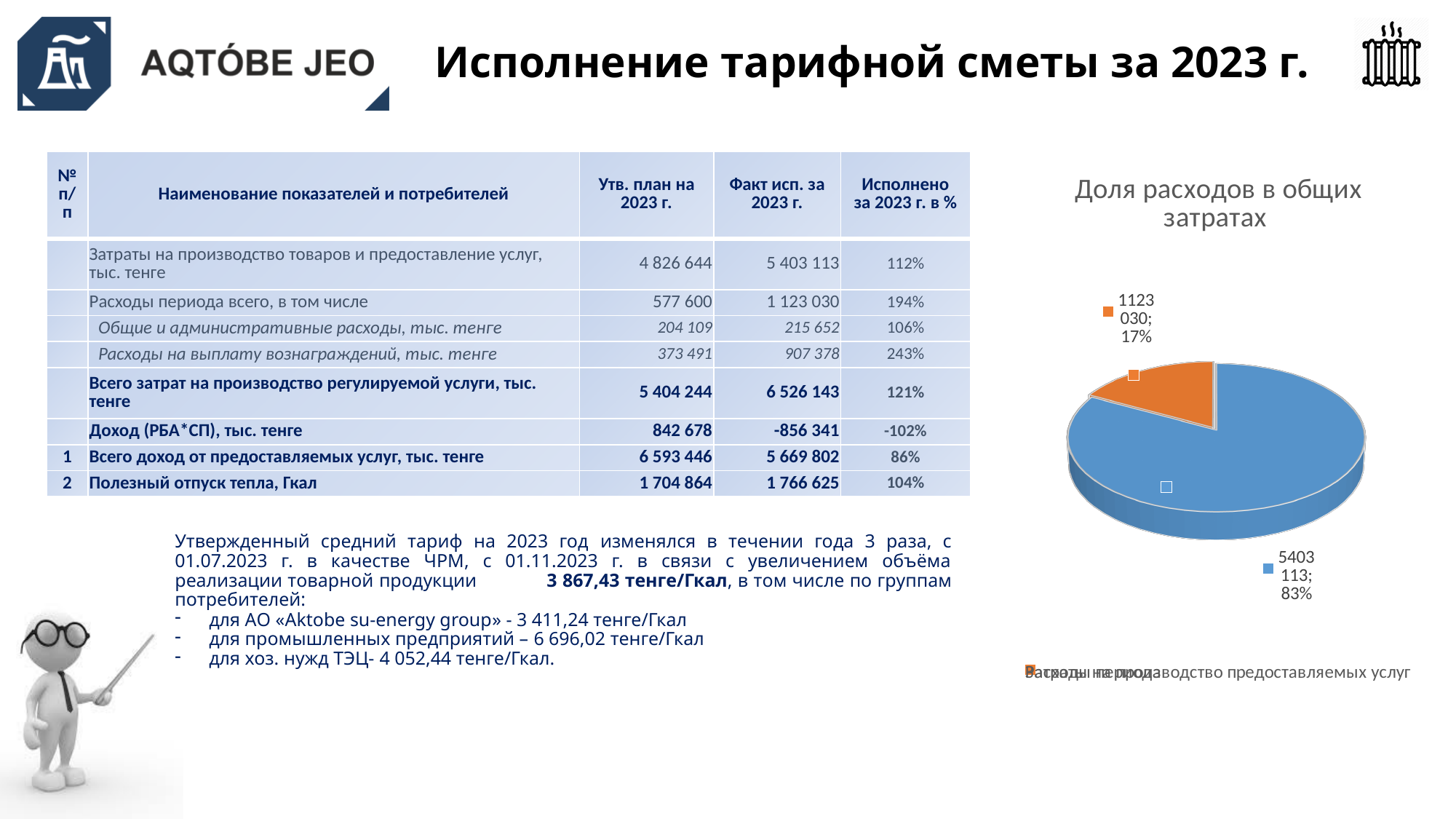
What kind of chart is shown under the title "Доля расходов в общих затратах"? pie chart In the pie chart "Доля расходов в общих затратах", what share does the orange slice represent? 17% In the pie chart "Доля расходов в общих затратах", which slice is the smallest? the orange slice (17%) In the pie chart "Доля расходов в общих затратах", what value is labelled on the blue slice? 5403 113 What is the title of the pie chart on the right side of the slide? Доля расходов в общих затратах How many slices does the pie chart "Доля расходов в общих затратах" have? 2 In the pie chart "Доля расходов в общих затратах", which slice is the largest? the blue slice (83%) In the pie chart "Доля расходов в общих затратах", what share does the blue slice represent? 83% In the pie chart "Доля расходов в общих затратах", is the blue slice or the orange slice larger? the blue slice In the pie chart "Доля расходов в общих затратах", what value is labelled on the orange slice? 1123 030 In the pie chart "Доля расходов в общих затратах", what colour is the slice representing 17%? orange In the pie chart "Доля расходов в общих затратах", what is the difference in percentage points between the blue slice's share and the orange slice's share? 66 percentage points